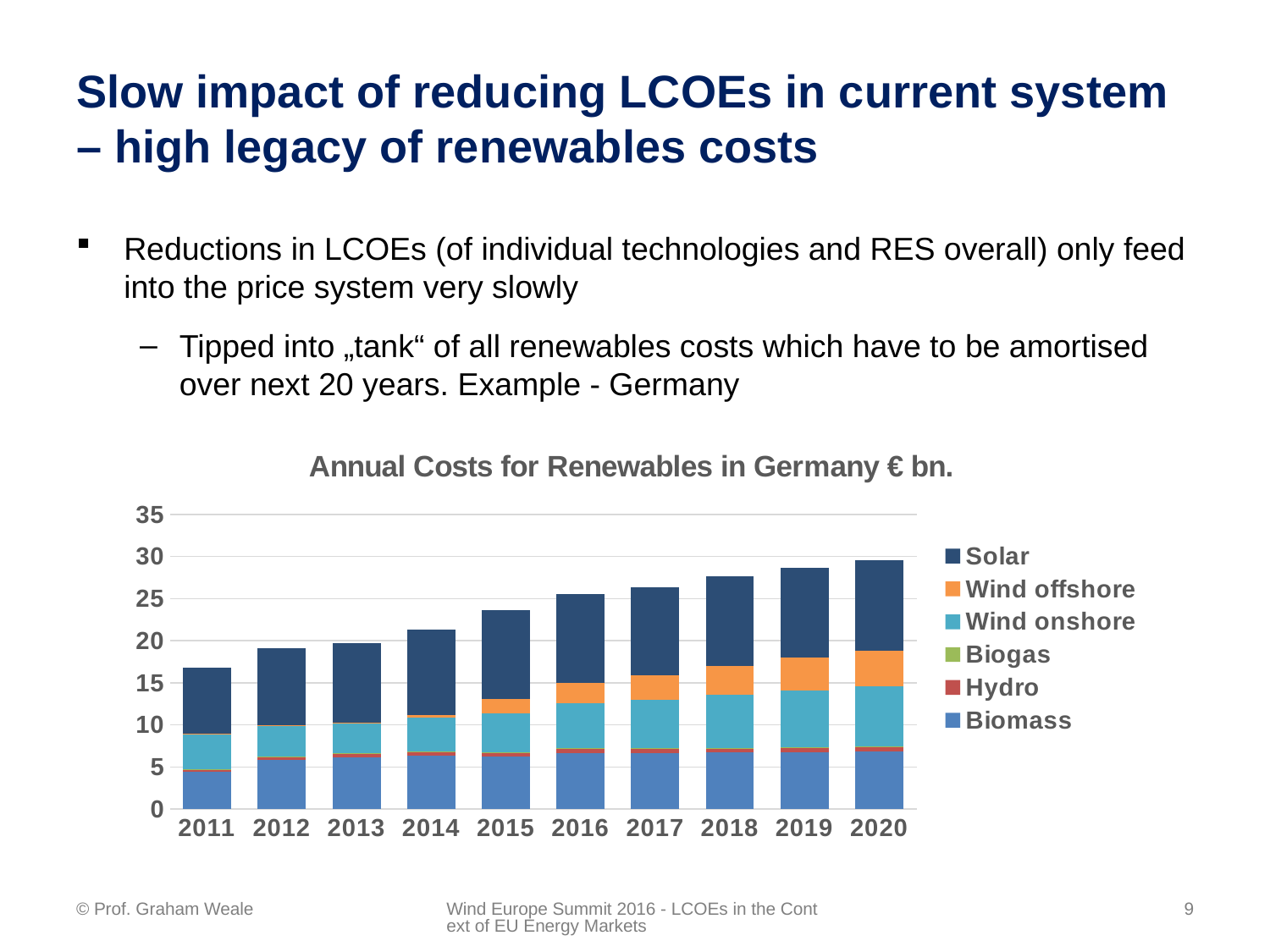
Is the total annual cost for 2018 greater or less than 25? greater Which year has the highest total annual cost for renewables? 2020 Which year has the lowest total annual cost for renewables? 2011 Is the total annual cost for 2011 greater or less than 20? less Which year has the larger total annual cost, 2012 or 2019? 2019 Which series is listed first (at the top) in the chart's legend? Solar How many years are shown on the x axis of the chart? 10 Is the total annual cost for 2020 greater or less than 25? greater What is the title of the chart? Annual Costs for Renewables in Germany € bn. Do the total annual costs rise or fall from 2011 to 2020? rise What kind of chart is shown on the slide? stacked bar chart How many series does the chart's legend list? 6